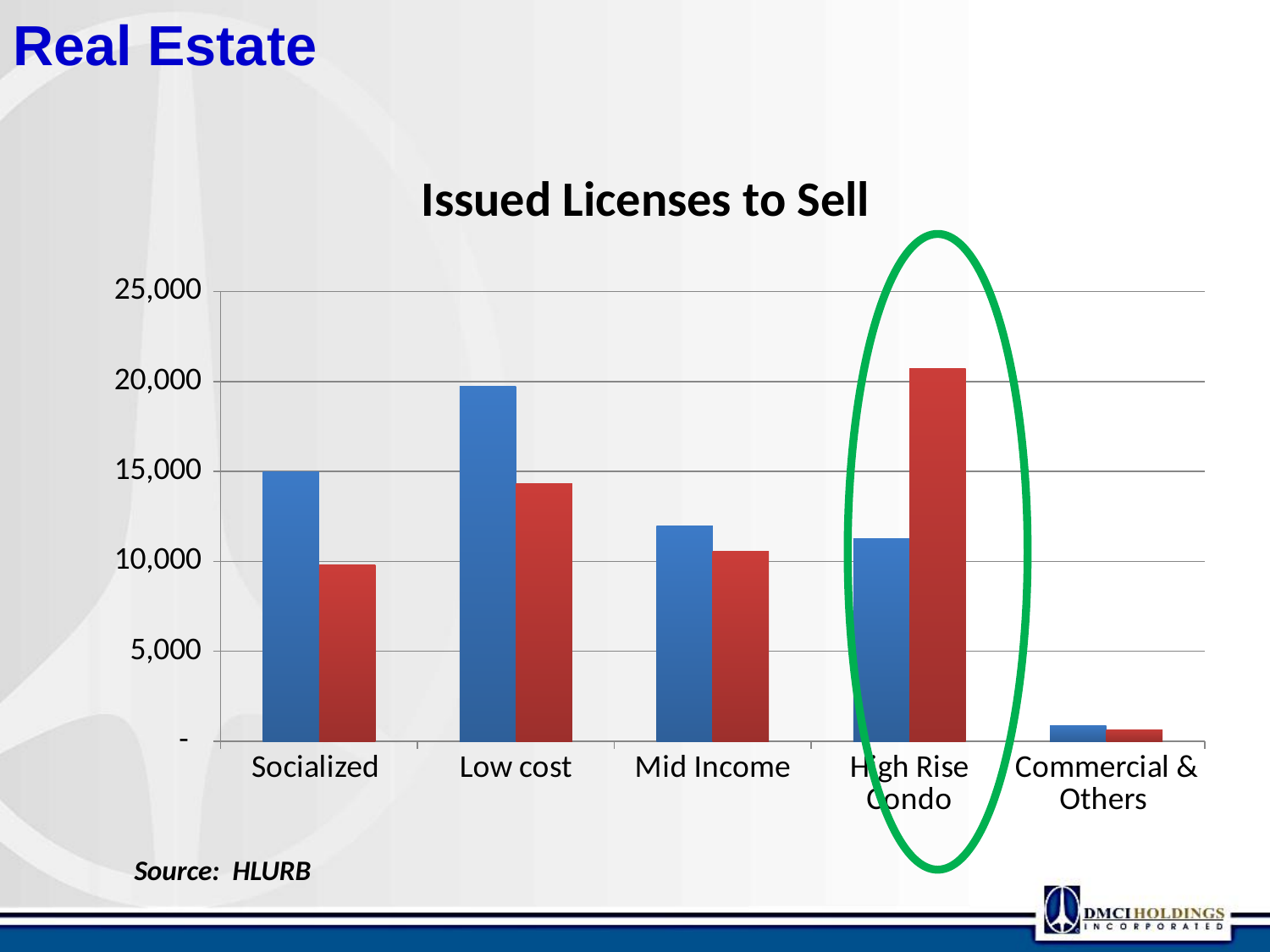
For Low cost, which bar is taller, the blue one or the red one? blue Is the red bar for Socialized greater or less than 15,000? less Which category has the tallest red bar? High Rise Condo Which category has the tallest blue bar? Low cost What is the title of the chart? Issued Licenses to Sell Is the blue bar for Mid Income greater or less than 10,000? greater For High Rise Condo, which bar is taller, the blue one or the red one? red Which category has the shortest blue bar? Commercial & Others How many categories are shown on the x axis of the chart? 5 What kind of chart is shown on the slide? bar chart Is the red bar for High Rise Condo greater or less than 20,000? greater